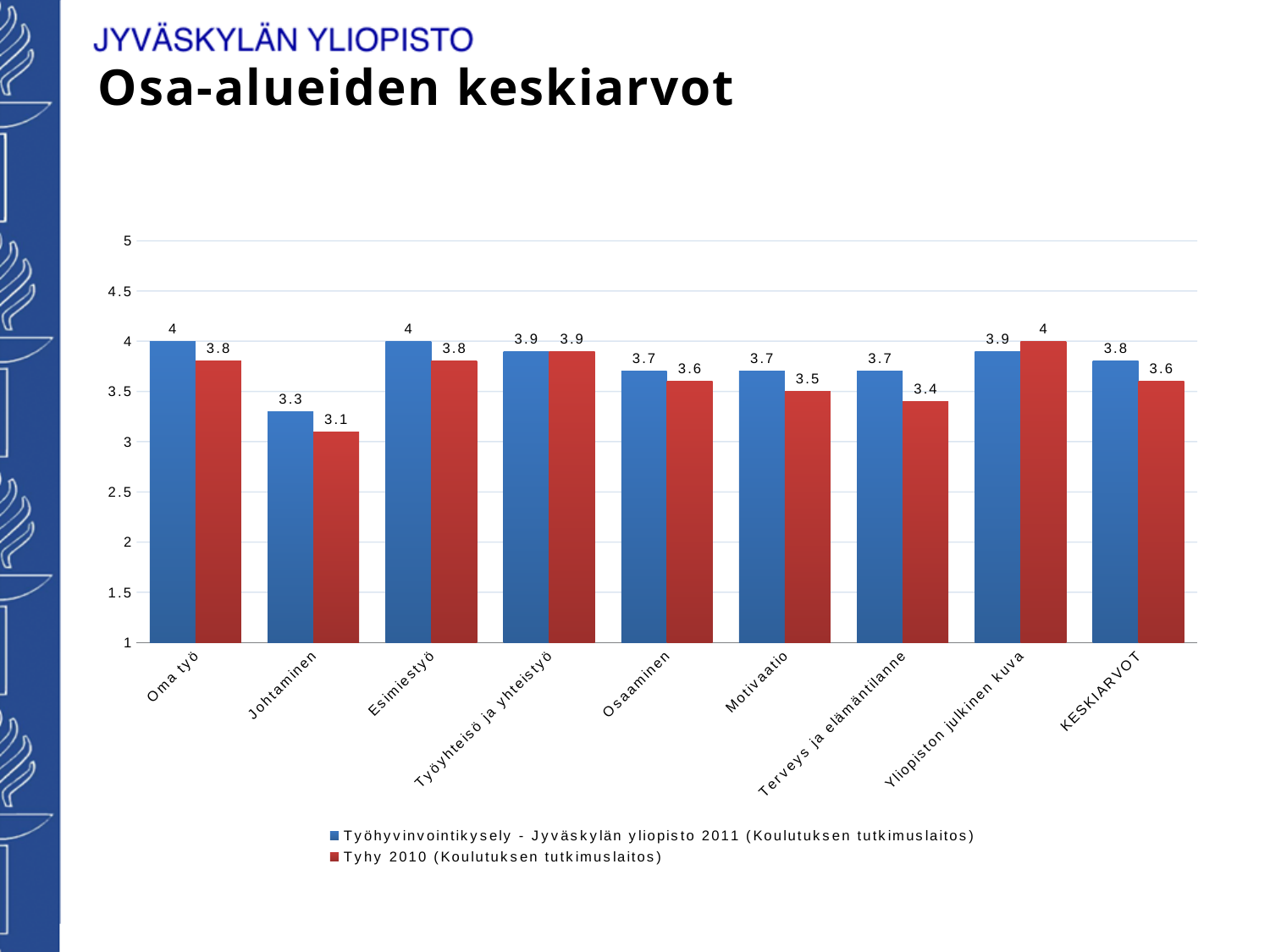
Which category has the lowest value in the Tyhy 2010 series? Johtaminen What is the difference between the 2011 and 2010 values for Terveys ja elämäntilanne? 0.3 What is the title of the slide containing the chart? Osa-alueiden keskiarvot Is the Tyhy 2010 value for Johtaminen greater or less than 3.5? less What is the KESKIARVOT value for the Työhyvinvointikysely 2011 series? 3.8 For Yliopiston julkinen kuva, which series has the larger value, Työhyvinvointikysely 2011 or Tyhy 2010? Tyhy 2010 Which category has the highest value in the Tyhy 2010 series? Yliopiston julkinen kuva What kind of chart is shown on the slide? Bar chart What is the value for Johtaminen in the Työhyvinvointikysely 2011 series? 3.3 How many categories are shown on the x axis? 9 How many series does the legend list? 2 What is the value for Terveys ja elämäntilanne in the Tyhy 2010 series? 3.4